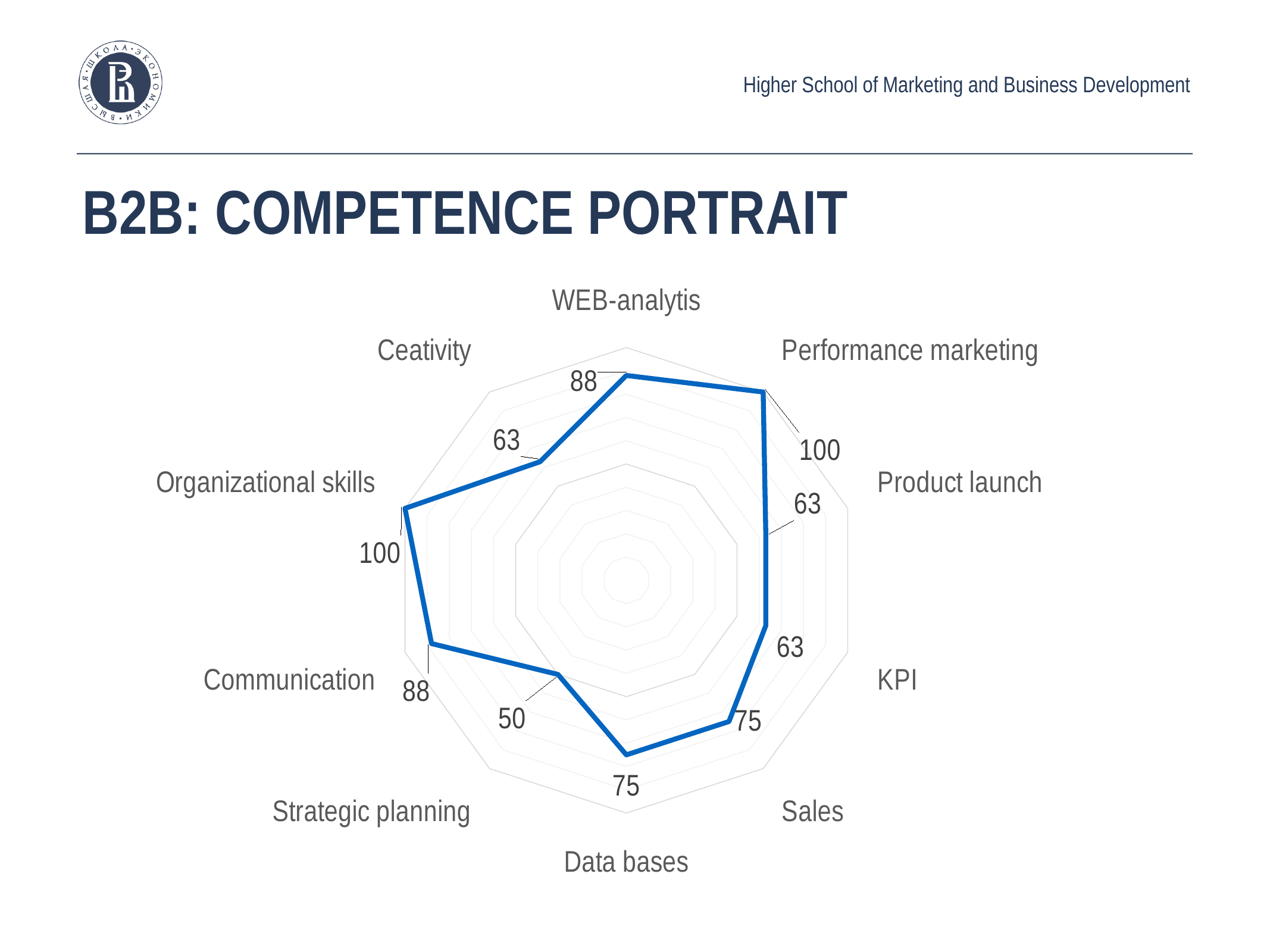
Which category has the lowest value? Strategic planning What is the value for Sales? 75 How many competence categories are plotted on the chart? 10 Which is larger, the value for Data bases or the value for Product launch? Data bases What kind of chart is shown on the slide? Radar chart What is the difference between the values for Performance marketing and KPI? 37 What is the title of the slide containing the chart? B2B: COMPETENCE PORTRAIT What is the value for WEB-analytis? 88 Which categories share the highest value of 100? Performance marketing and Organizational skills What is the difference between the values for Communication and Strategic planning? 38 What is the value for Organizational skills? 100 What is the value for Strategic planning? 50